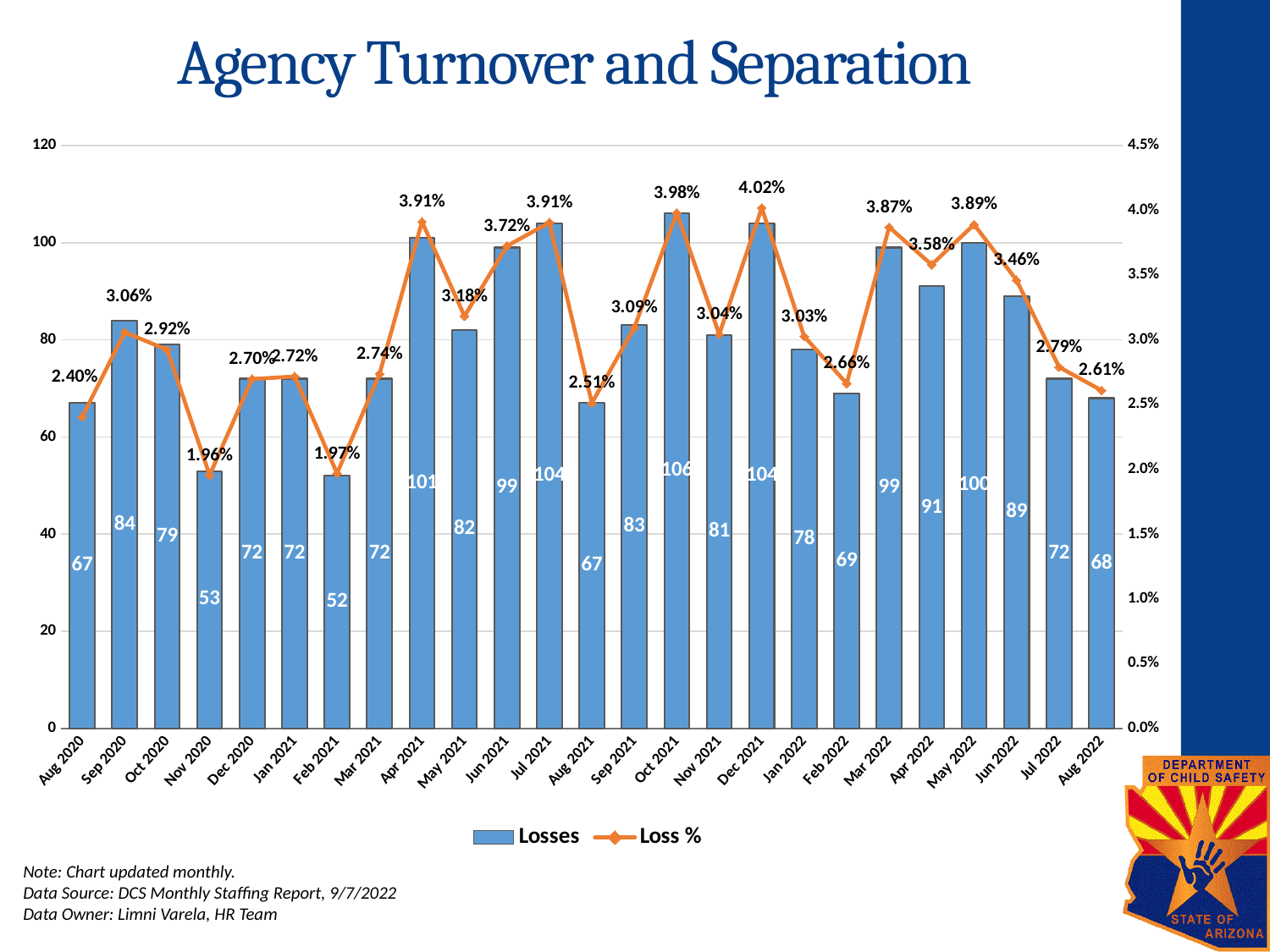
Which is larger, the Losses value for Sep 2020 or for Oct 2020? Sep 2020 What is the difference in Losses between Jul 2021 and Aug 2021? 37 What is the Loss % value for Dec 2021? 4.02% What type of chart is shown on the slide? Combined bar and line chart Which month has the highest Loss % value? Dec 2021 What are the two series named in the legend? Losses and Loss % How many series does the legend list? 2 Which month has the lowest Losses value? Feb 2021 What is the Losses value for Nov 2020? 53 What is the Losses value for Apr 2022? 91 Which month has the highest Losses value? Oct 2021 How many months are plotted along the x axis? 25